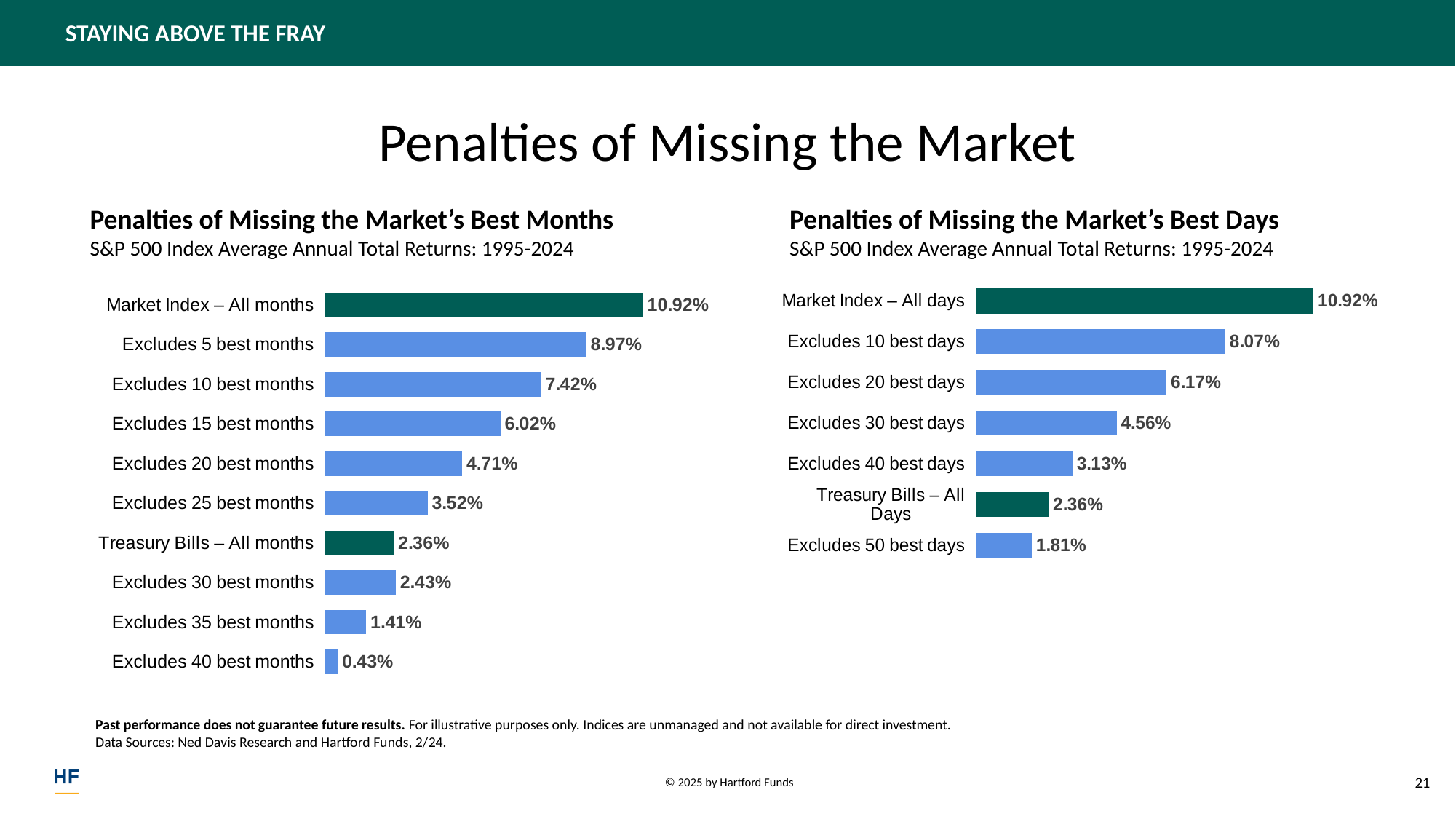
In the 'Penalties of Missing the Market's Best Days' chart, what is the difference between 'Excludes 10 best days' and 'Excludes 20 best days'? 1.90% In the 'Penalties of Missing the Market's Best Days' chart, what is the value for 'Excludes 30 best days'? 4.56% What kind of chart is the 'Penalties of Missing the Market's Best Days' chart? Bar chart In the 'Penalties of Missing the Market's Best Days' chart, which category has the highest value? Market Index – All days In the 'Penalties of Missing the Market's Best Months' chart, which is larger: 'Treasury Bills – All months' or 'Excludes 30 best months'? Excludes 30 best months How many categories are shown in the 'Penalties of Missing the Market's Best Days' chart? 7 In the 'Penalties of Missing the Market's Best Months' chart, which category has the lowest value? Excludes 40 best months What is the subtitle shown under the 'Penalties of Missing the Market's Best Months' chart title? S&P 500 Index Average Annual Total Returns: 1995-2024 How many categories are shown in the 'Penalties of Missing the Market's Best Months' chart? 10 In the 'Penalties of Missing the Market's Best Months' chart, what is the value for 'Excludes 10 best months'? 7.42% In the 'Penalties of Missing the Market's Best Days' chart, which is larger: 'Treasury Bills – All Days' or 'Excludes 50 best days'? Treasury Bills – All Days In the 'Penalties of Missing the Market's Best Months' chart, what is the difference between 'Market Index – All months' and 'Excludes 5 best months'? 1.95%